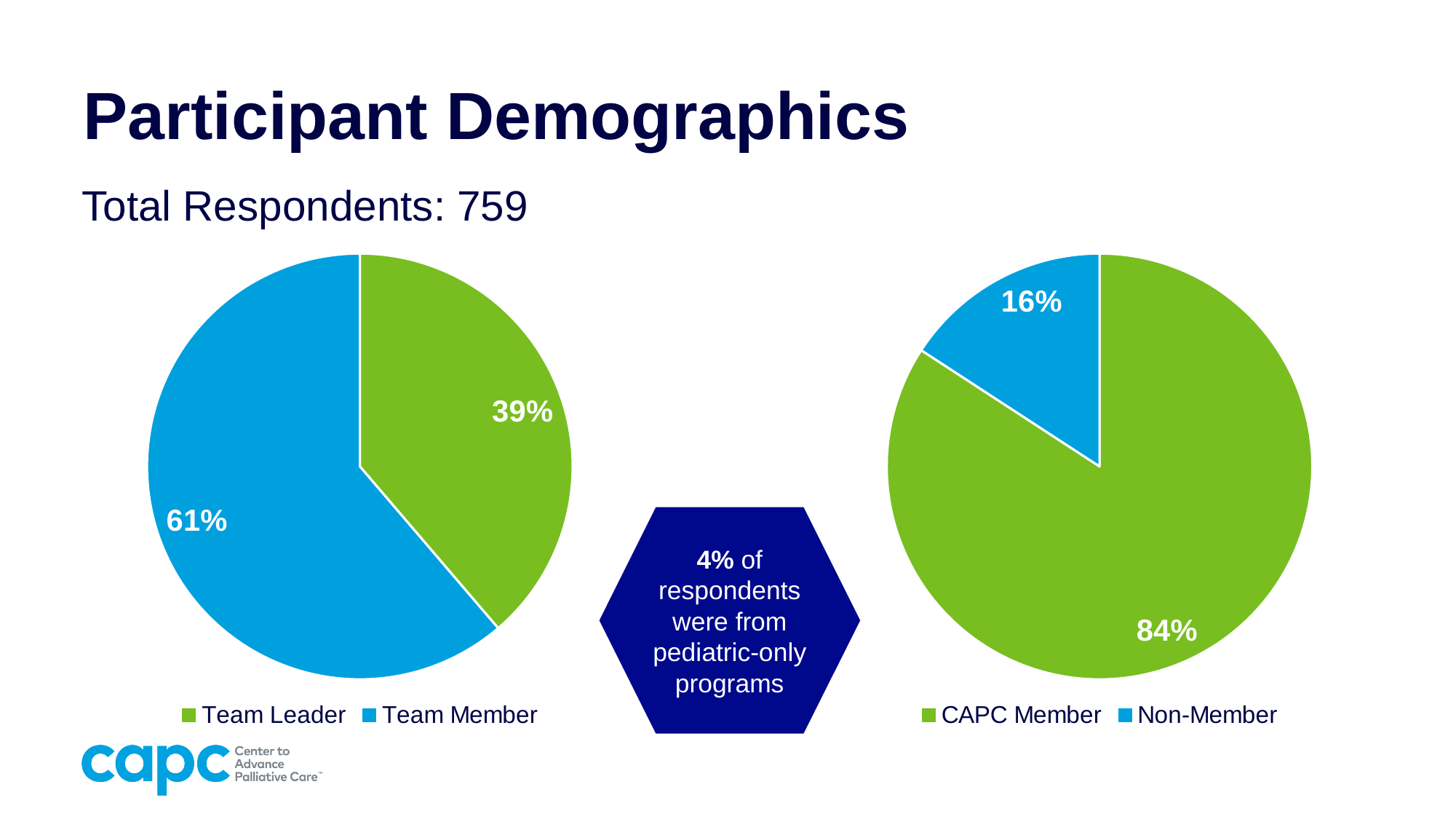
What kind of chart is the left chart on the slide? pie chart How many categories does the legend of the right pie chart list? 2 In the right pie chart, which category has the smaller share? Non-Member In the right pie chart, what share of respondents are Non-Members? 16% In the left pie chart, what is the difference between the Team Member and Team Leader shares? 22% In the left pie chart, what share of respondents are Team Members? 61% In the right pie chart, what share of respondents are CAPC Members? 84% In the left pie chart, what share of respondents are Team Leaders? 39% In the right pie chart, is the share for CAPC Member larger or smaller than the share for Non-Member? larger In the left pie chart, what colour is the Team Member slice? blue In the left pie chart, which category has the larger share? Team Member In the right pie chart, what is the difference between the CAPC Member and Non-Member shares? 68%